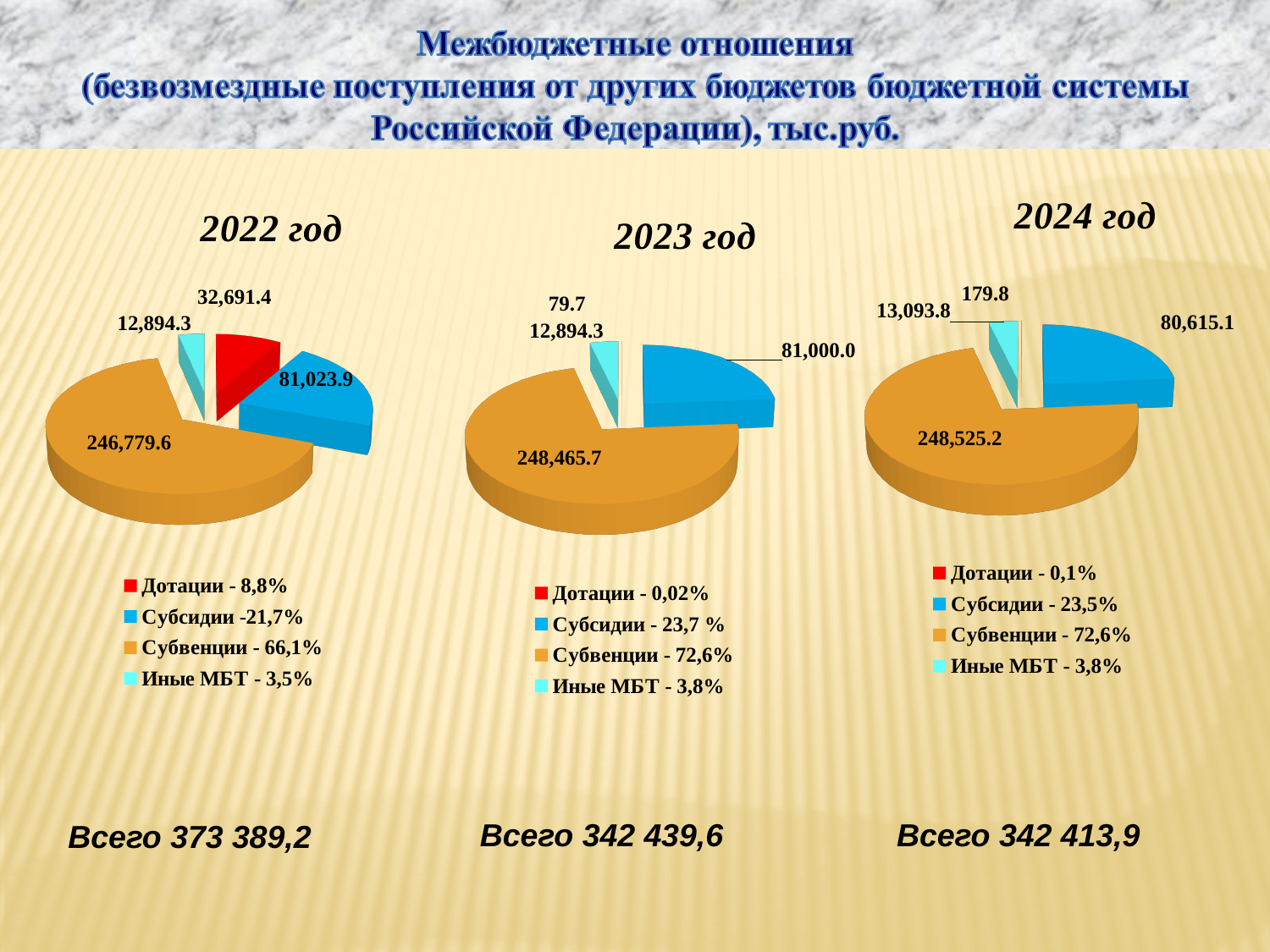
In the 2024 год pie chart, which category has the smallest value? Дотации In the 2022 год pie chart, what share does Субвенции have according to the legend? 66,1% How many slices does the 2023 год pie chart have? 4 In the 2023 год pie chart, what is the value for Дотации? 79.7 In the 2024 год pie chart, what is the value for Субсидии? 80,615.1 In the 2024 год pie chart, what share does Иные МБТ have according to the legend? 3,8% In the 2023 год pie chart, which is larger: Субсидии or Иные МБТ? Субсидии In the 2022 год pie chart, what is the value for Субвенции? 246,779.6 In the 2022 год pie chart, which category has the largest value? Субвенции What type of chart is used for 2024 год? Pie chart What colour represents Дотации in the 2022 год pie chart? Red In the 2022 год pie chart, what is the difference between the values for Субсидии and Иные МБТ? 68,129.6